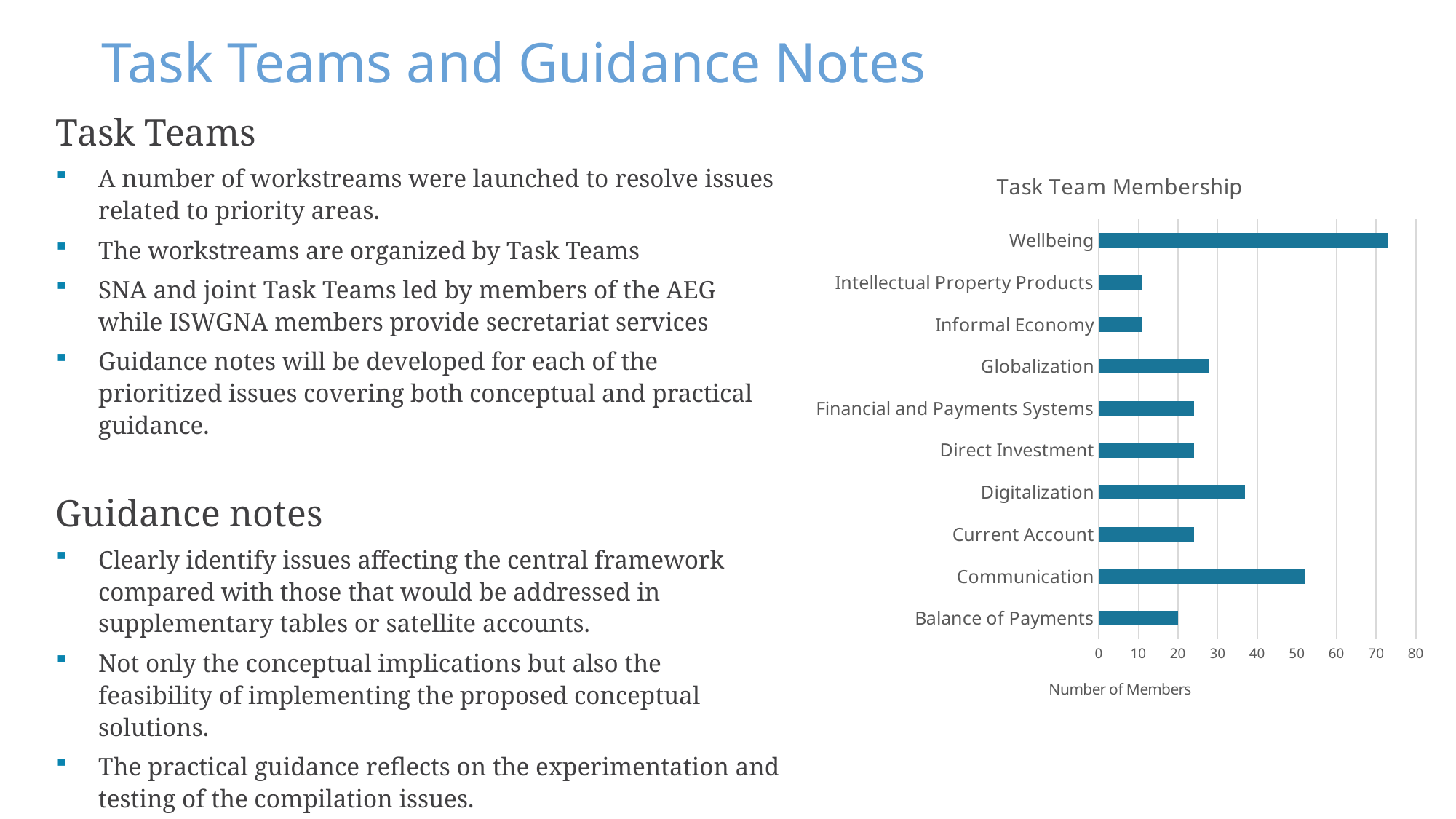
Is the value for Digitalization greater or less than 30? greater Is the value for Wellbeing greater or less than 70? greater Which task team has the highest number of members? Wellbeing Is the value for Globalization greater or less than 40? less What is the title of the chart? Task Team Membership Which has more members, Globalization or Informal Economy? Globalization What type of chart is shown on the slide? bar chart What is the label on the horizontal axis of the chart? Number of Members How many task teams are shown in the chart? 10 Which has more members, Communication or Digitalization? Communication